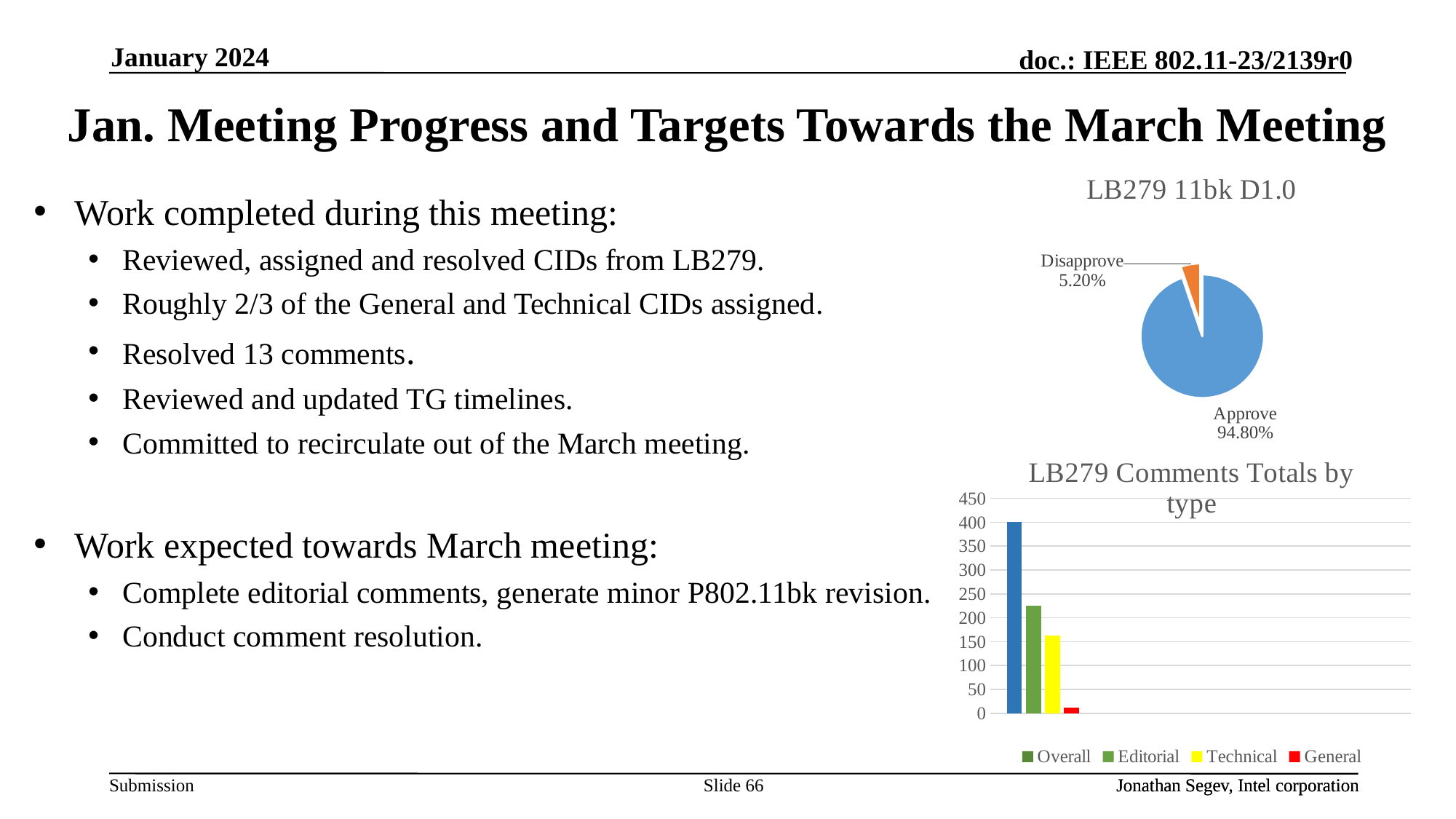
On the LB279 11bk D1.0 chart, what percentage of votes were Approve? 94.80% What kind of chart is the LB279 11bk D1.0 chart? pie chart What kind of chart is the LB279 Comments Totals by type chart? bar chart On the LB279 Comments Totals by type chart, how many series does the legend list? 4 On the LB279 11bk D1.0 chart, how many slices does the pie have? 2 On the LB279 Comments Totals by type chart, is the value for Overall greater or less than 350? greater On the LB279 11bk D1.0 chart, which slice is the largest? Approve On the LB279 11bk D1.0 chart, what is the difference between the Approve and Disapprove shares? 89.60% On the LB279 Comments Totals by type chart, which series has the lowest value? General On the LB279 Comments Totals by type chart, which is larger, Editorial or Technical? Editorial On the LB279 Comments Totals by type chart, which series has the highest value? Overall On the LB279 11bk D1.0 chart, what percentage of votes were Disapprove? 5.20%